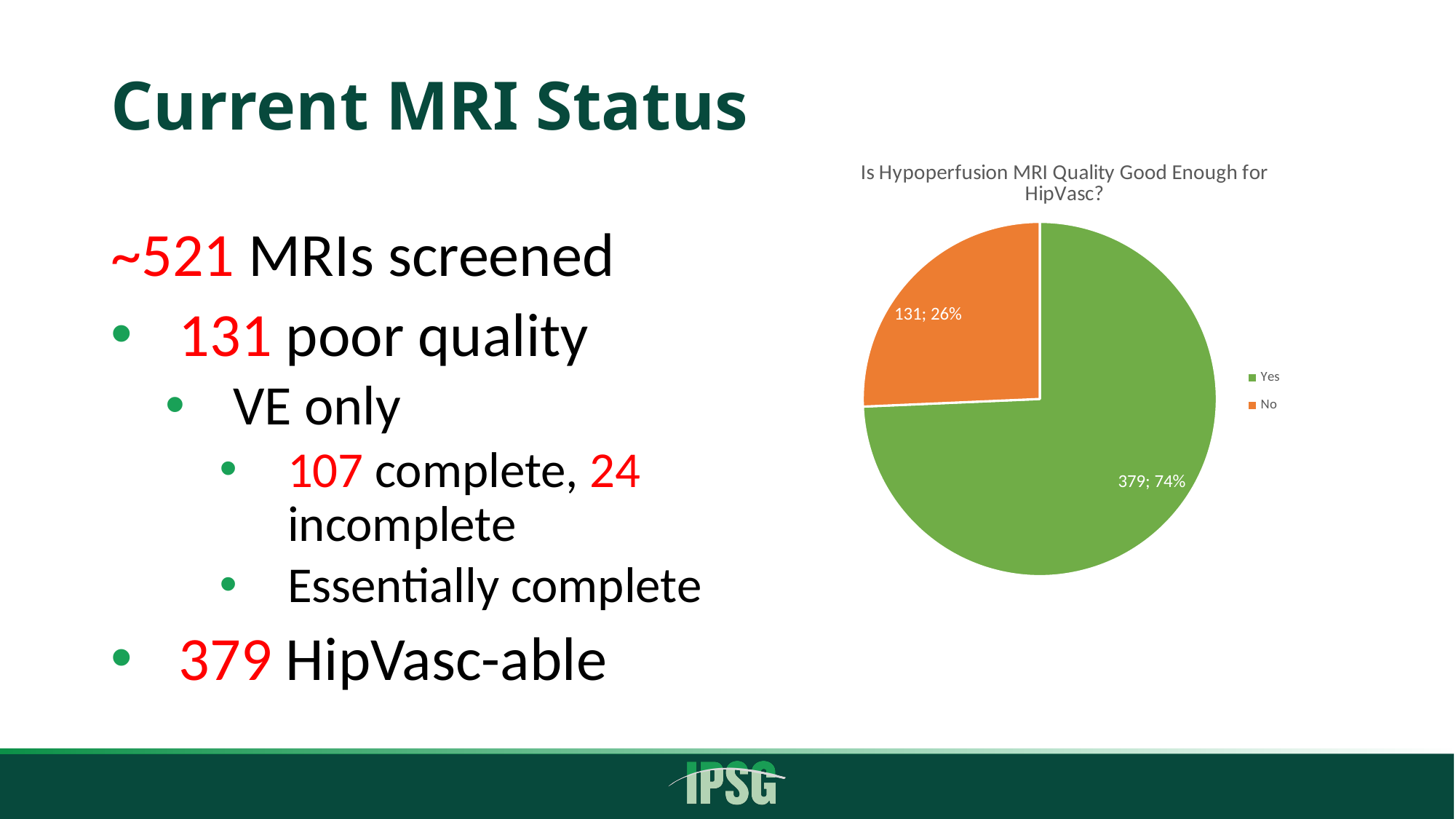
What is the difference between the Yes and No values in the pie chart? 248 How many slices does the pie chart have? 2 What share of the pie does the No slice represent? 26% What is the value for the No slice of the pie chart? 131 What kind of chart is shown on the slide? pie chart What is the title of the pie chart? Is Hypoperfusion MRI Quality Good Enough for HipVasc? Which is larger in the pie chart, Yes or No? Yes Which slice of the pie chart is the largest? Yes What share of the pie does the Yes slice represent? 74% What colour is the Yes slice in the pie chart? green What is the value for the Yes slice of the pie chart? 379 Which slice of the pie chart is the smallest? No